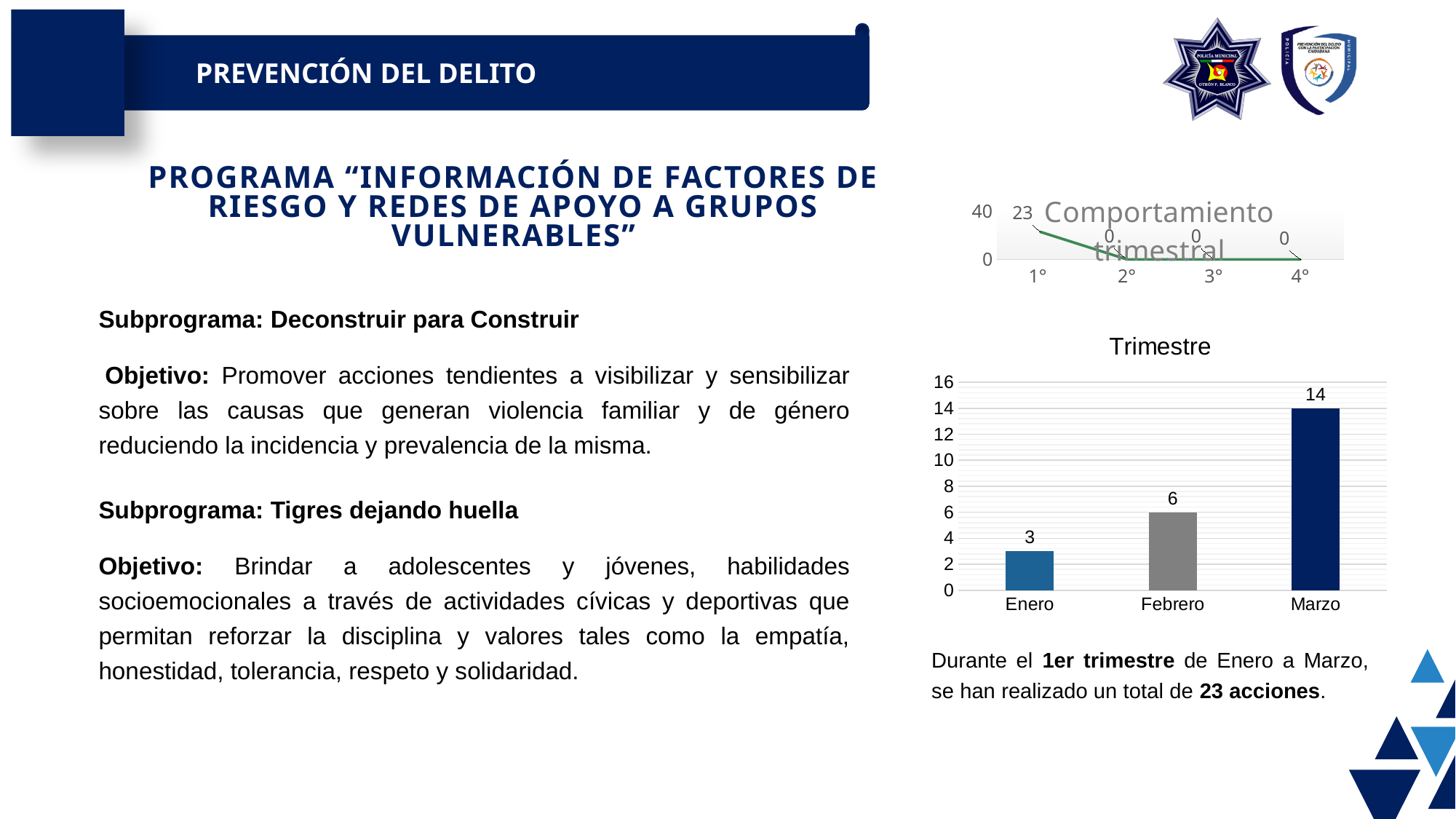
In the "Trimestre" chart, which month has the highest value? Marzo In the "Trimestre" chart, what is the value for Marzo? 14 In the "Trimestre" chart, do the values rise or fall from Enero to Marzo? Rise In the "Trimestre" chart, what is the difference between the values for Marzo and Febrero? 8 In the "Trimestre" chart, which is larger, the value for Febrero or the value for Enero? Febrero In the "Comportamiento trimestral" chart, what is the value for 1°? 23 What kind of chart is the "Comportamiento trimestral" chart? Line chart In the "Trimestre" chart, what is the value for Febrero? 6 In the "Trimestre" chart, which month has the lowest value? Enero What kind of chart is the "Trimestre" chart? Bar chart In the "Trimestre" chart, what is the value for Enero? 3 How many months are shown in the "Trimestre" chart? 3